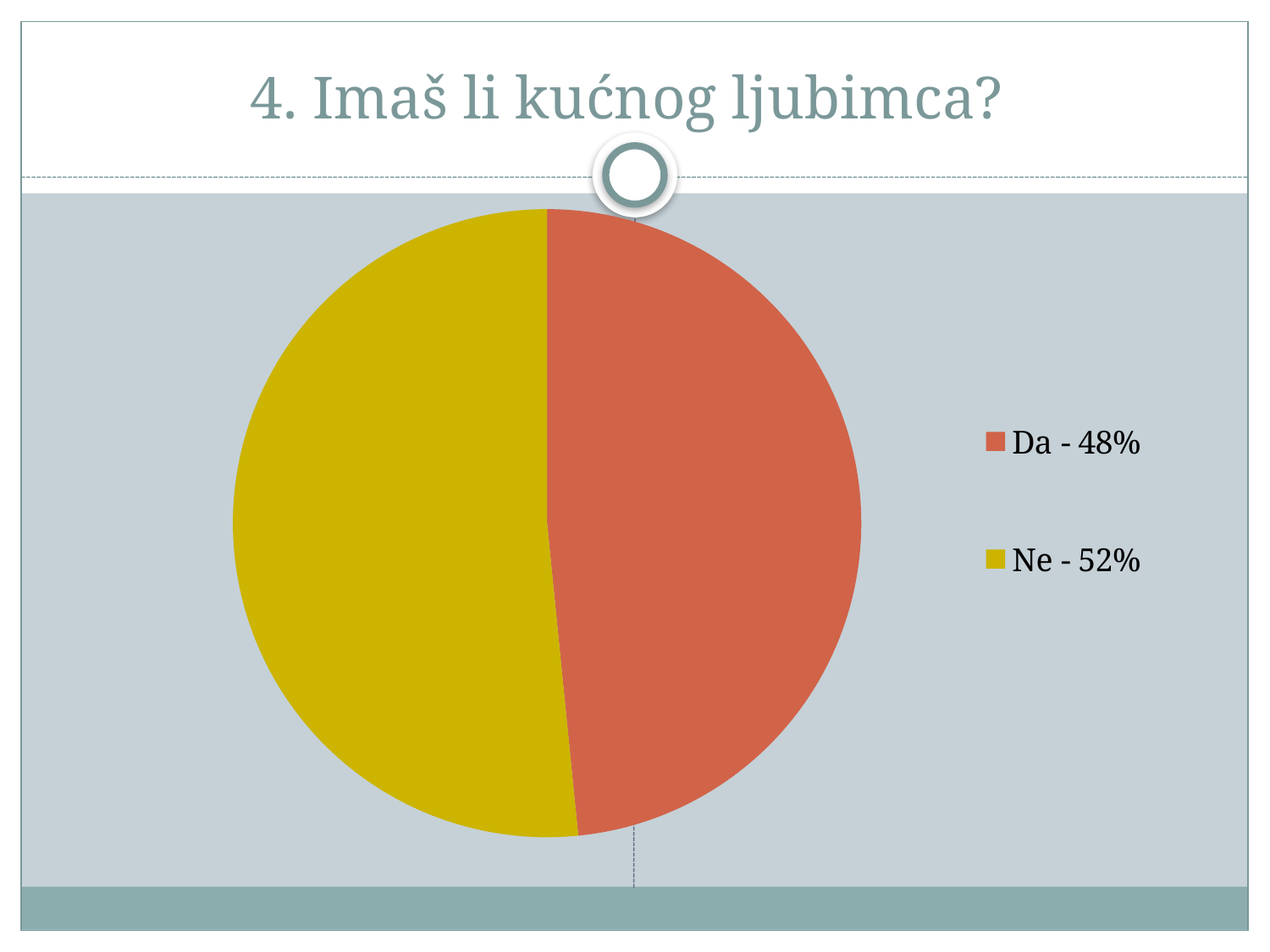
What kind of chart is shown on the slide? pie chart What is the title of the slide containing the pie chart? 4. Imaš li kućnog ljubimca? What colour is the "Ne" slice of the pie chart? yellow What share of the pie does the "Ne" slice represent? 52% Is the share for "Da" larger or smaller than the share for "Ne"? smaller What share of the pie does the "Da" slice represent? 48% Which category has the larger share of the pie? Ne Is the share for "Ne" greater or less than 50%? greater How many slices does the pie chart have? 2 Which category has the smaller share of the pie? Da How many entries does the legend list? 2 What is the difference in percentage points between the "Ne" and "Da" slices? 4